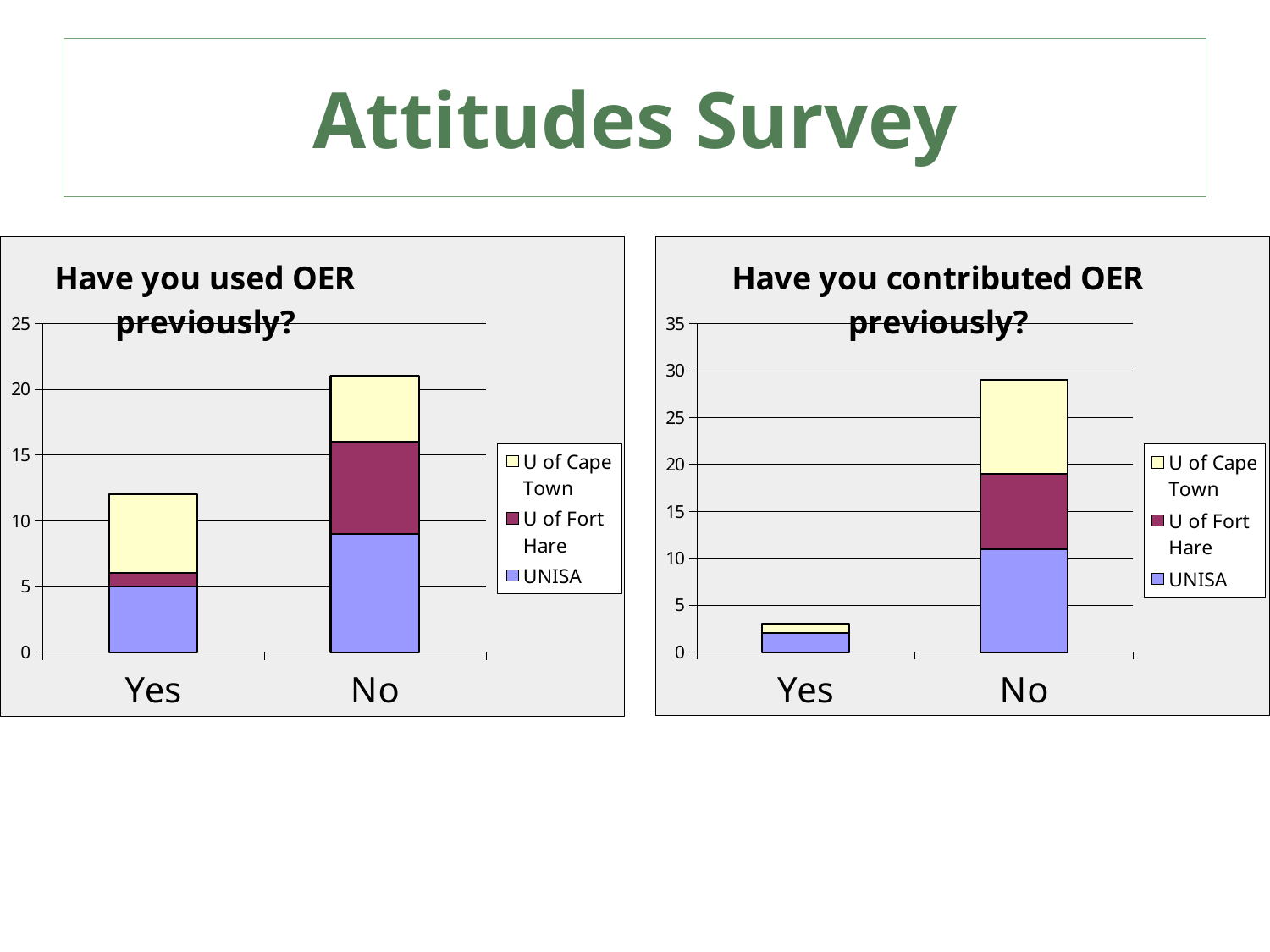
What kind of chart is the 'Have you used OER previously?' chart? stacked bar chart In the 'Have you used OER previously?' chart, is the total height of the Yes bar greater or less than 10? greater How many series does the legend of the 'Have you contributed OER previously?' chart list? 3 In the 'Have you used OER previously?' chart, is the total height of the No bar greater or less than 15? greater In the 'Have you contributed OER previously?' chart, is the total height of the Yes bar greater or less than 5? less In the 'Have you contributed OER previously?' chart, which category has the shorter stacked bar? Yes How many categories are shown on the x axis of the 'Have you used OER previously?' chart? 2 In the 'Have you used OER previously?' chart, which category has the taller stacked bar, Yes or No? No Which series is shown in pale yellow in the legend of the 'Have you used OER previously?' chart? U of Cape Town What is the title of the chart on the right side of the slide? Have you contributed OER previously?